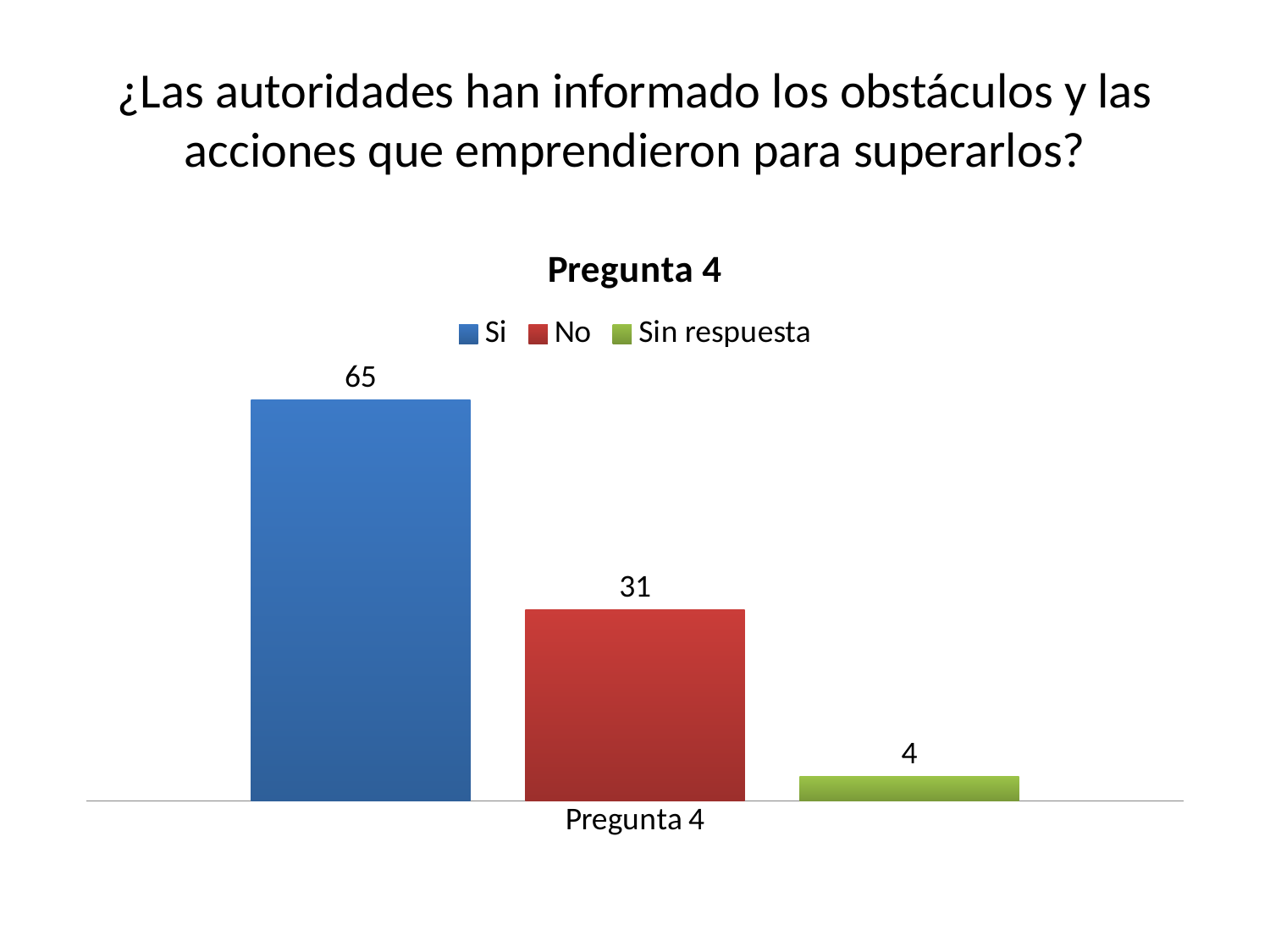
What is the value for Si? 65 What is the difference between the values for No and Sin respuesta? 27 Which series has the lowest value? Sin respuesta Which series has the highest value? Si What colour is the bar for No? Red How many series does the legend list? 3 What kind of chart is shown? Bar chart What is the value for Sin respuesta? 4 Which is larger, the value for Si or the value for No? Si What is the value for No? 31 What is the difference between the values for Si and No? 34 What is the title of the chart? Pregunta 4